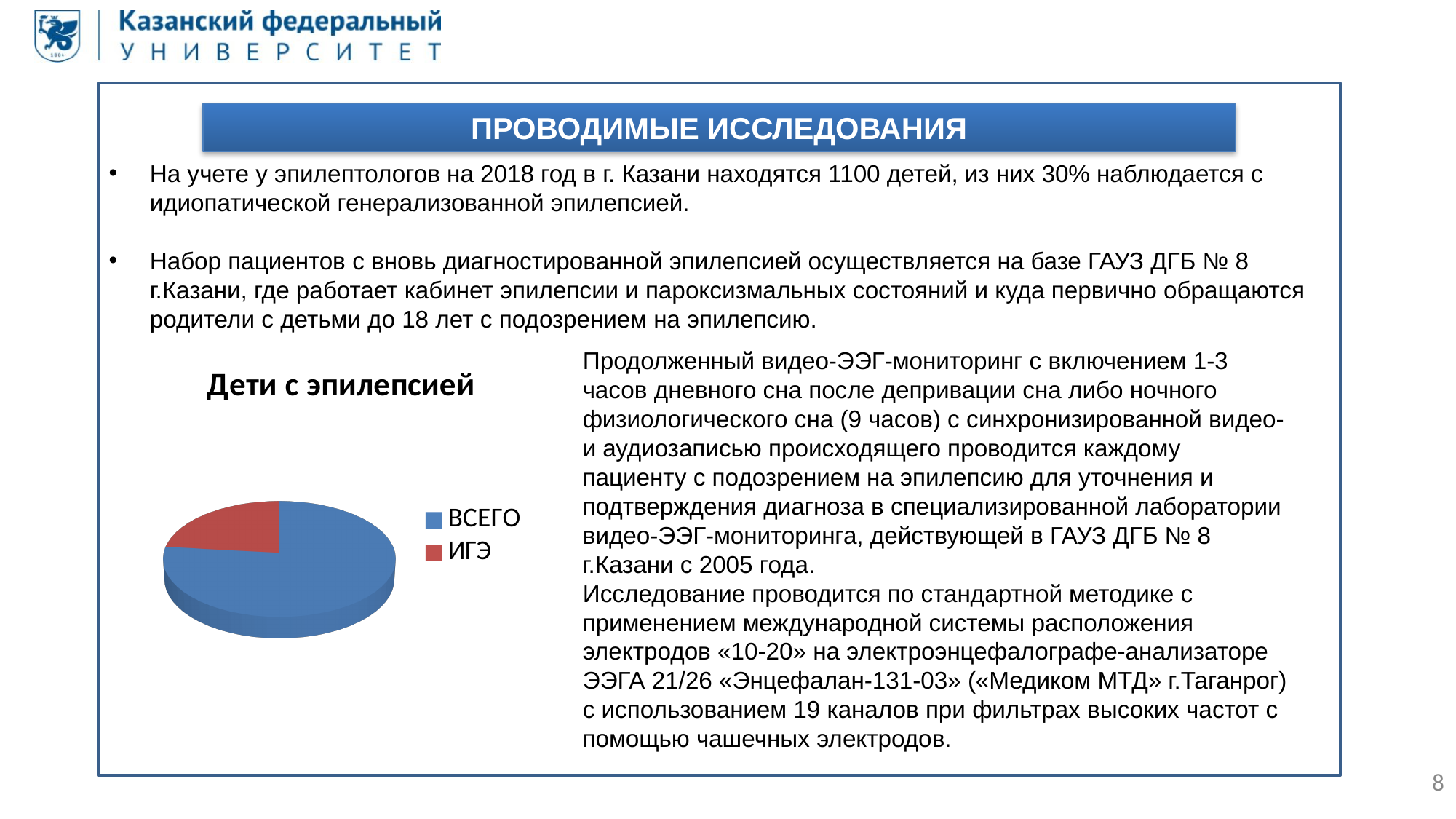
How many slices does the pie chart have? 2 Which slice of the pie chart is the smallest? ИГЭ Which slice is larger in the pie chart, ВСЕГО or ИГЭ? ВСЕГО What colour is the ИГЭ slice in the pie chart? Red What kind of chart is shown on the slide? Pie chart Which slice of the pie chart is the largest? ВСЕГО Which legend entry is shown in blue in the pie chart? ВСЕГО How many entries does the legend of the pie chart list? 2 What is the title of the pie chart? Дети с эпилепсией